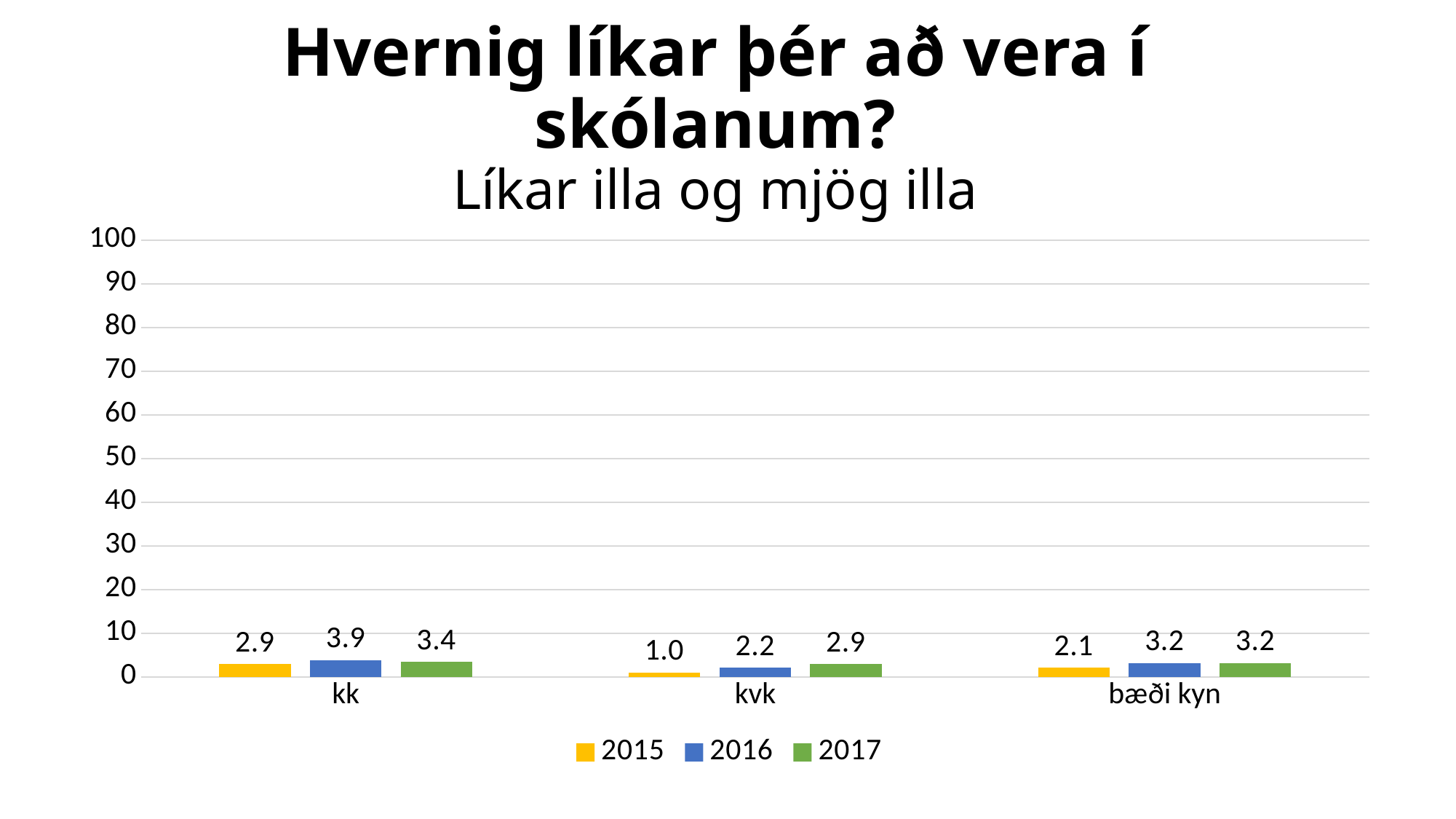
Is the value for kk in 2016 greater or less than 10? less Which category has the lowest value in 2015? kvk What is the value for bæði kyn in 2017? 3.2 What kind of chart is shown? bar chart Which is larger for kk: the 2015 value or the 2017 value? 2017 Which series is shown in green in the legend? 2017 How many categories are shown on the x axis? 3 Which category has the highest value in 2016? kk What is the difference between the 2017 and 2015 values for kvk? 1.9 How many series does the legend list? 3 What is the value for kvk in 2015? 1.0 What is the value for kk in 2016? 3.9